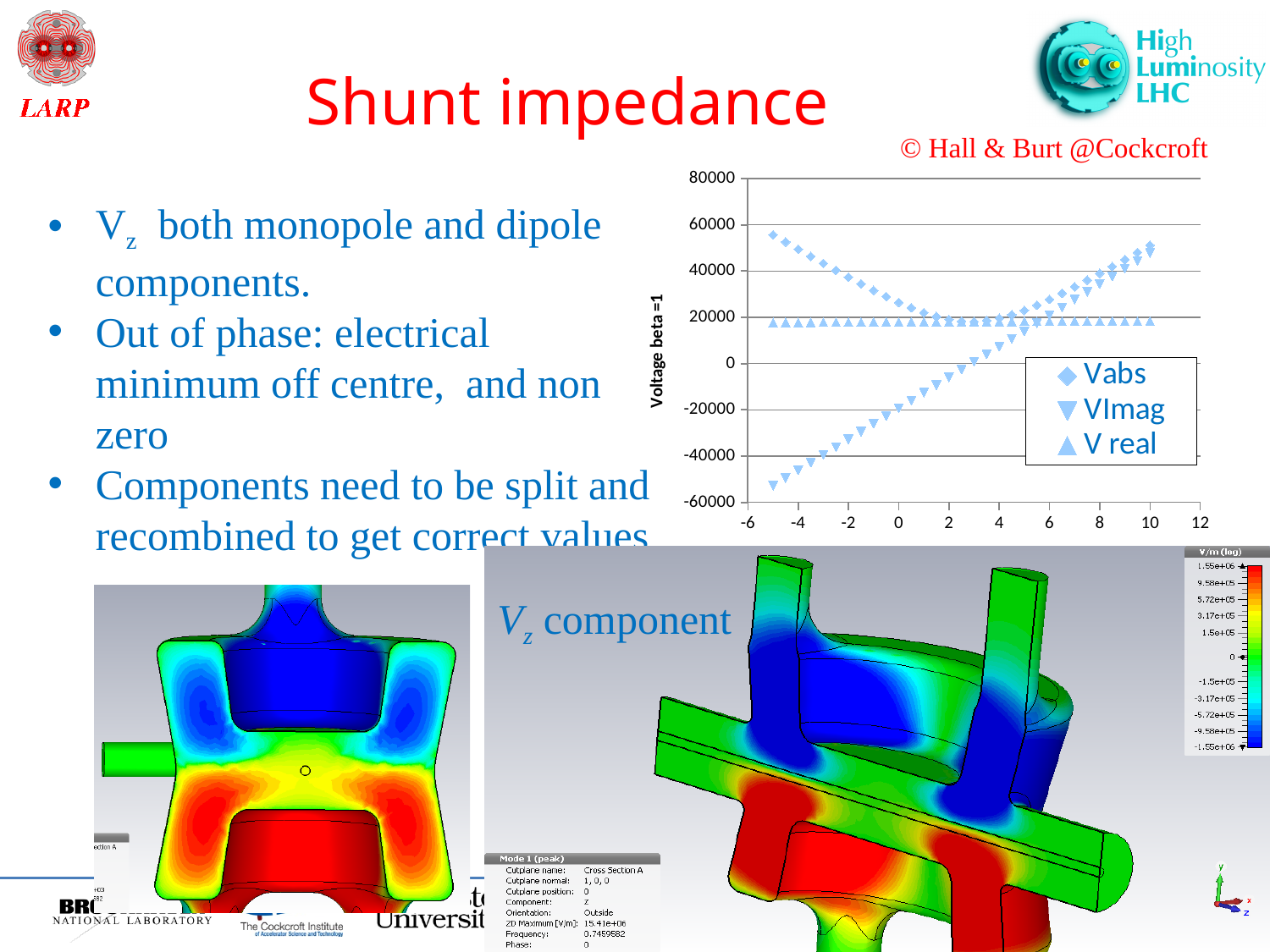
Is the value of the Vabs series at x = -5 greater or less than 40000? greater Is the value of the V real series at x = 0 greater or less than 0? greater What kind of chart is shown on the slide? scatter chart Is the value of the VImag series at x = 8 greater or less than 20000? greater What is the title of the chart's vertical axis? Voltage beta =1 How many series does the chart legend list? 3 Does the VImag series rise or fall as x increases from -5 to 10? rise At x = 10, which series has the larger value, Vabs or V real? Vabs At x = -4, which series has the larger value, Vabs or VImag? Vabs What are the three series named in the chart legend? Vabs, VImag, V real